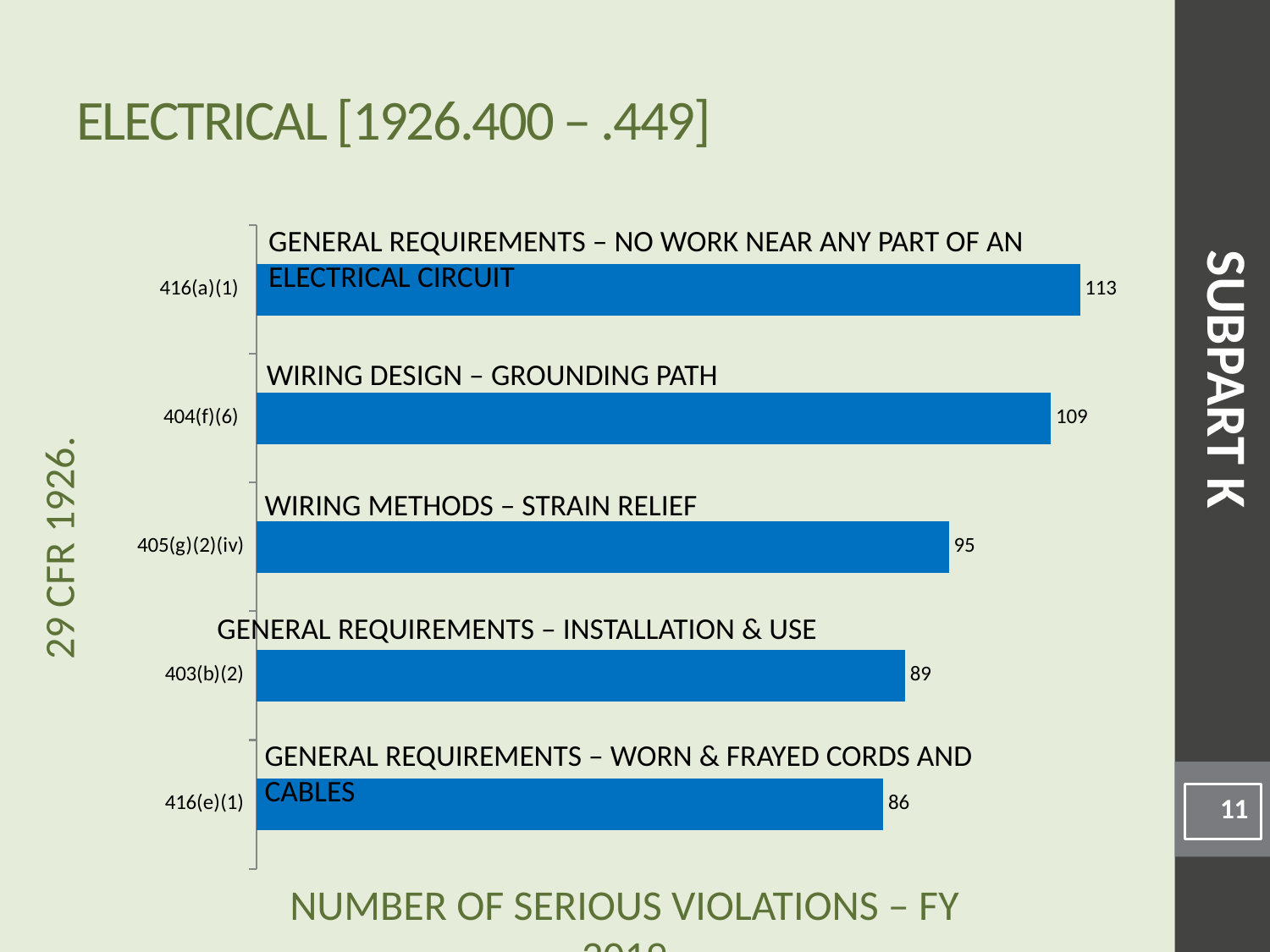
What is the number of serious violations for 405(g)(2)(iv)? 95 How many standards are shown in the chart? 5 What type of chart is shown on the slide? Bar chart What is the number of serious violations for 416(e)(1)? 86 What is the number of serious violations for 403(b)(2)? 89 Which standard has the lowest number of serious violations? 416(e)(1) Which has more serious violations, 403(b)(2) or 405(g)(2)(iv)? 405(g)(2)(iv) What is the difference in serious violations between 416(a)(1) and 416(e)(1)? 27 What is the number of serious violations for 404(f)(6)? 109 Which standard has the highest number of serious violations? 416(a)(1) What is the number of serious violations for 416(a)(1)? 113 What is the difference in serious violations between 404(f)(6) and 405(g)(2)(iv)? 14